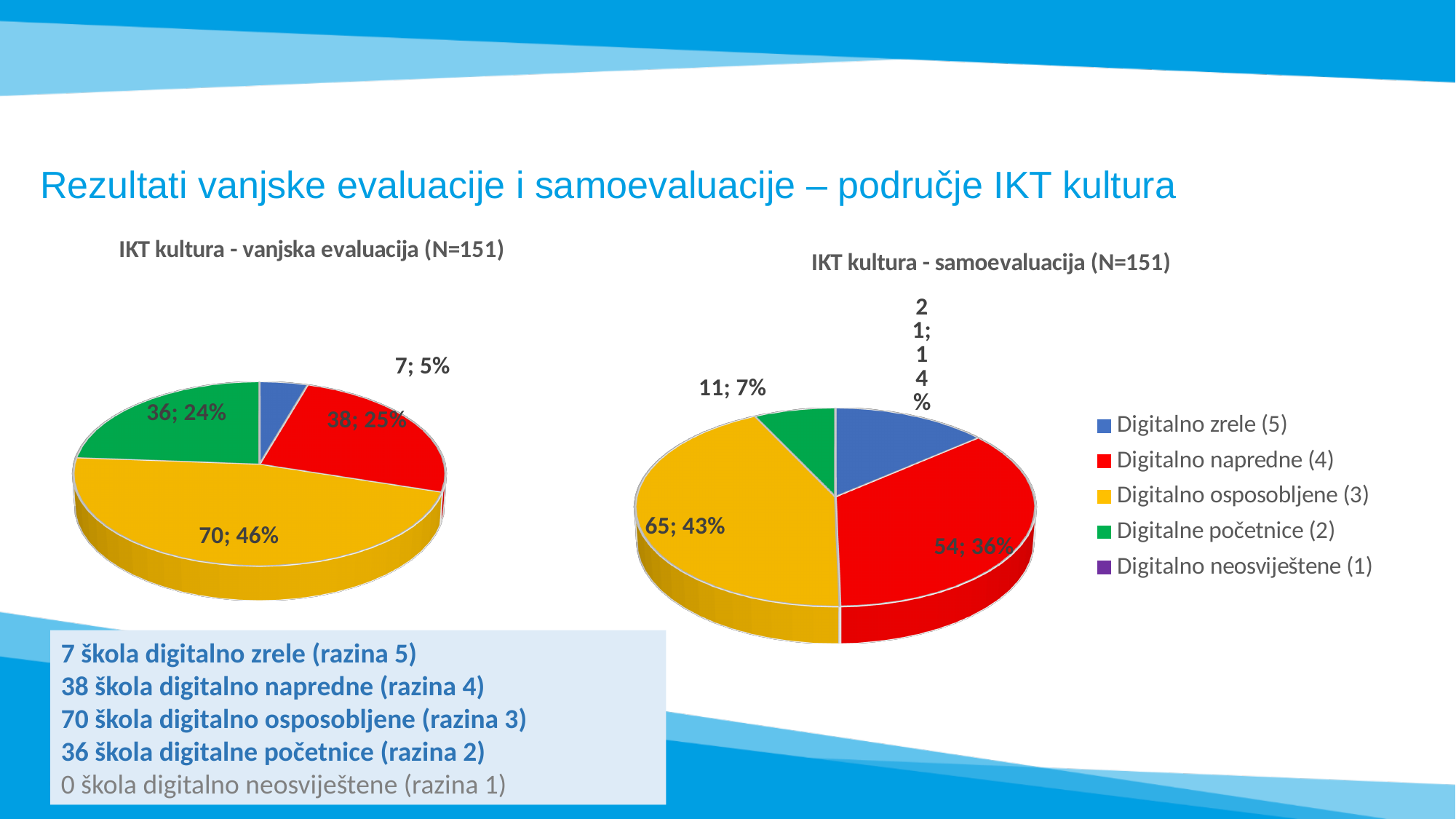
What kind of chart is used for "IKT kultura - vanjska evaluacija (N=151)"? pie chart In the "IKT kultura - vanjska evaluacija (N=151)" chart, what share of the pie does Digitalne početnice (2) take? 24% In the "IKT kultura - vanjska evaluacija (N=151)" chart, what is the difference between the counts for Digitalno napredne (4) and Digitalne početnice (2)? 2 In the "IKT kultura - vanjska evaluacija (N=151)" chart, what is the value for Digitalno osposobljene (3)? 70; 46% In the "IKT kultura - samoevaluacija (N=151)" chart, what is the value for Digitalne početnice (2)? 11; 7% In the "IKT kultura - samoevaluacija (N=151)" chart, which category has the smallest slice? Digitalne početnice (2) In the "IKT kultura - vanjska evaluacija (N=151)" chart, what is the value for Digitalno zrele (5)? 7; 5% Which chart has the larger count for Digitalno zrele (5): "IKT kultura - vanjska evaluacija (N=151)" or "IKT kultura - samoevaluacija (N=151)"? IKT kultura - samoevaluacija (N=151) In the "IKT kultura - vanjska evaluacija (N=151)" chart, which category has the largest slice? Digitalno osposobljene (3) In the "IKT kultura - samoevaluacija (N=151)" chart, what is the value for Digitalno napredne (4)? 54; 36% In the "IKT kultura - samoevaluacija (N=151)" chart, which is larger: Digitalno osposobljene (3) or Digitalno napredne (4)? Digitalno osposobljene (3) How many entries does the legend list? 5